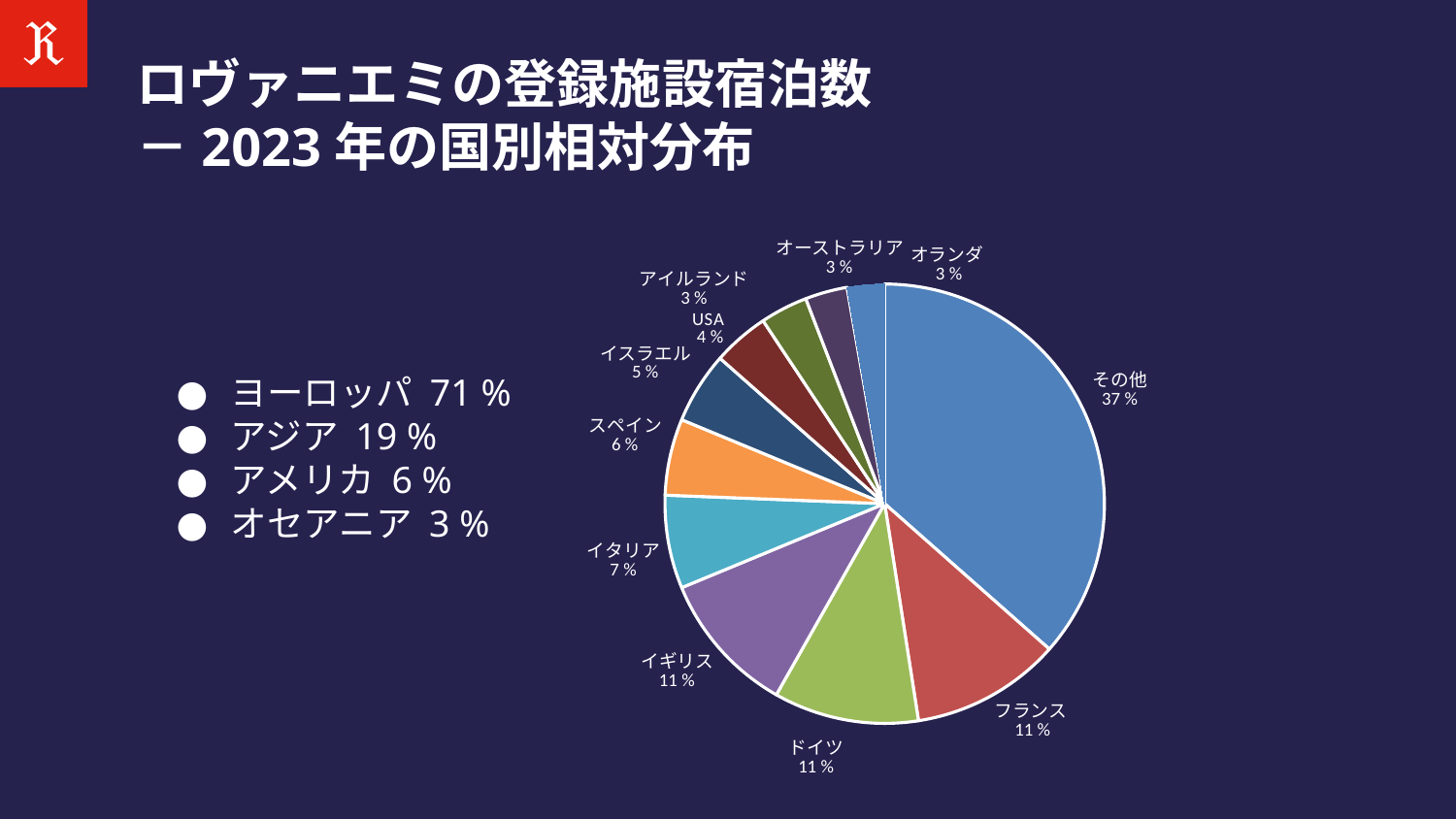
Which is larger, the share for スペイン or the share for イタリア? イタリア What is the difference between the shares of イタリア and USA? 3 % What is the difference between the shares of その他 and フランス? 26 % What is the value shown for USA? 4 % What is the value shown for イタリア (Italy)? 7 % Which is larger, the share for イギリス or the share for イスラエル? イギリス What share of the pie does その他 (Other) account for? 37 % How many slices does the pie chart have? 11 Which slice of the pie is the largest? その他 What is the value shown for イスラエル (Israel)? 5 % What year does the chart title say the distribution is for? 2023 What kind of chart is shown on the slide? pie chart